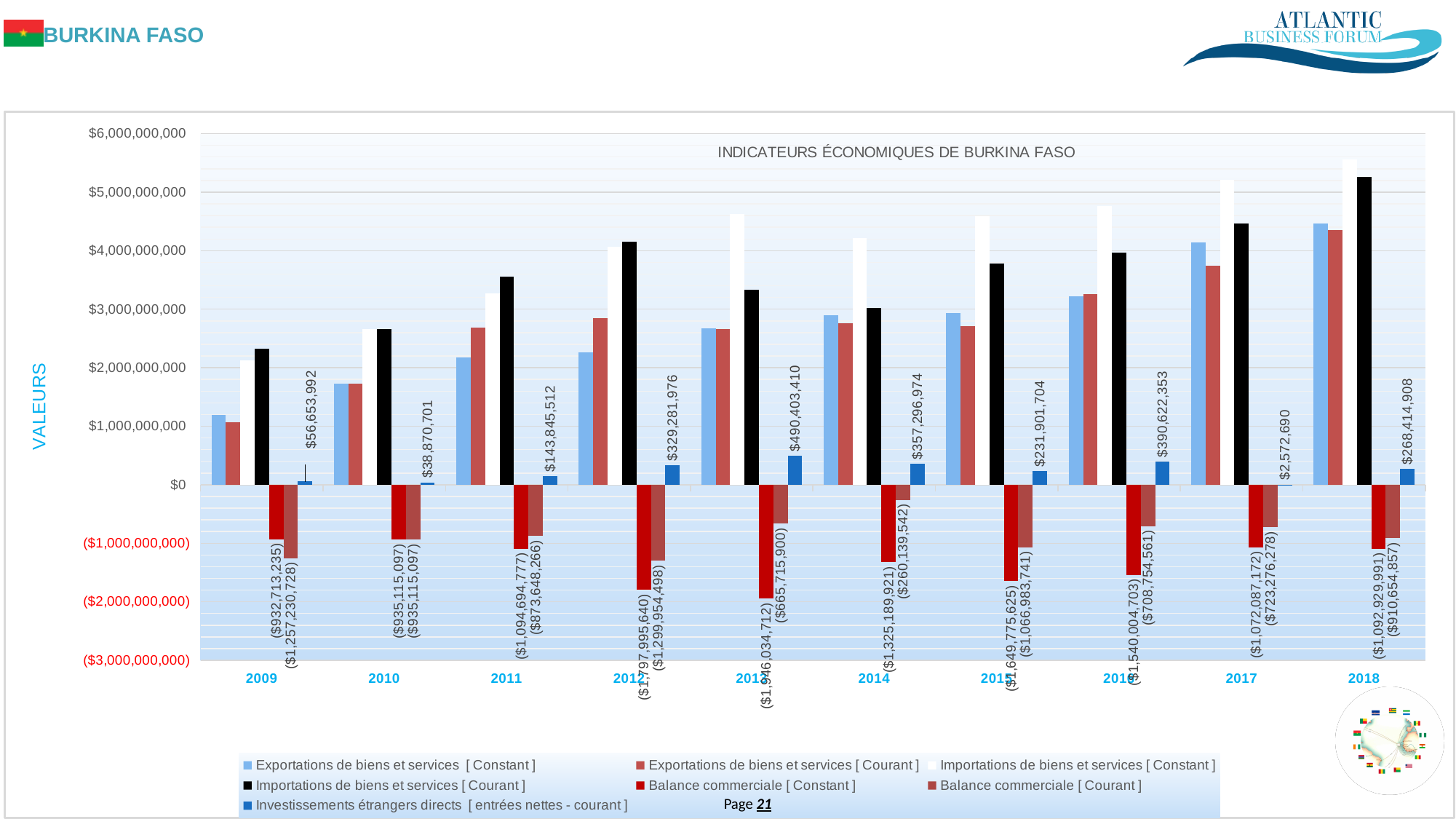
Do the values of Importations de biens et services [Courant] generally rise or fall from 2009 to 2018? rise In which year is the value of Investissements étrangers directs the highest? 2013 How many years are shown on the x axis of the chart? 10 How many series does the chart legend list? 7 Which year has the larger value of Investissements étrangers directs, 2012 or 2016? 2016 What is the difference between the Investissements étrangers directs values in 2013 and 2014? $133,106,436 What is the value of Investissements étrangers directs in 2013? $490,403,410 What type of chart is shown on the slide? bar chart What is the title of the chart? INDICATEURS ÉCONOMIQUES DE BURKINA FASO What is the value of Balance commerciale [Courant] in 2014? ($260,139,542) Is the value of Importations de biens et services [Courant] in 2018 greater or less than $5,000,000,000? greater In which year is the value of Investissements étrangers directs the lowest? 2017